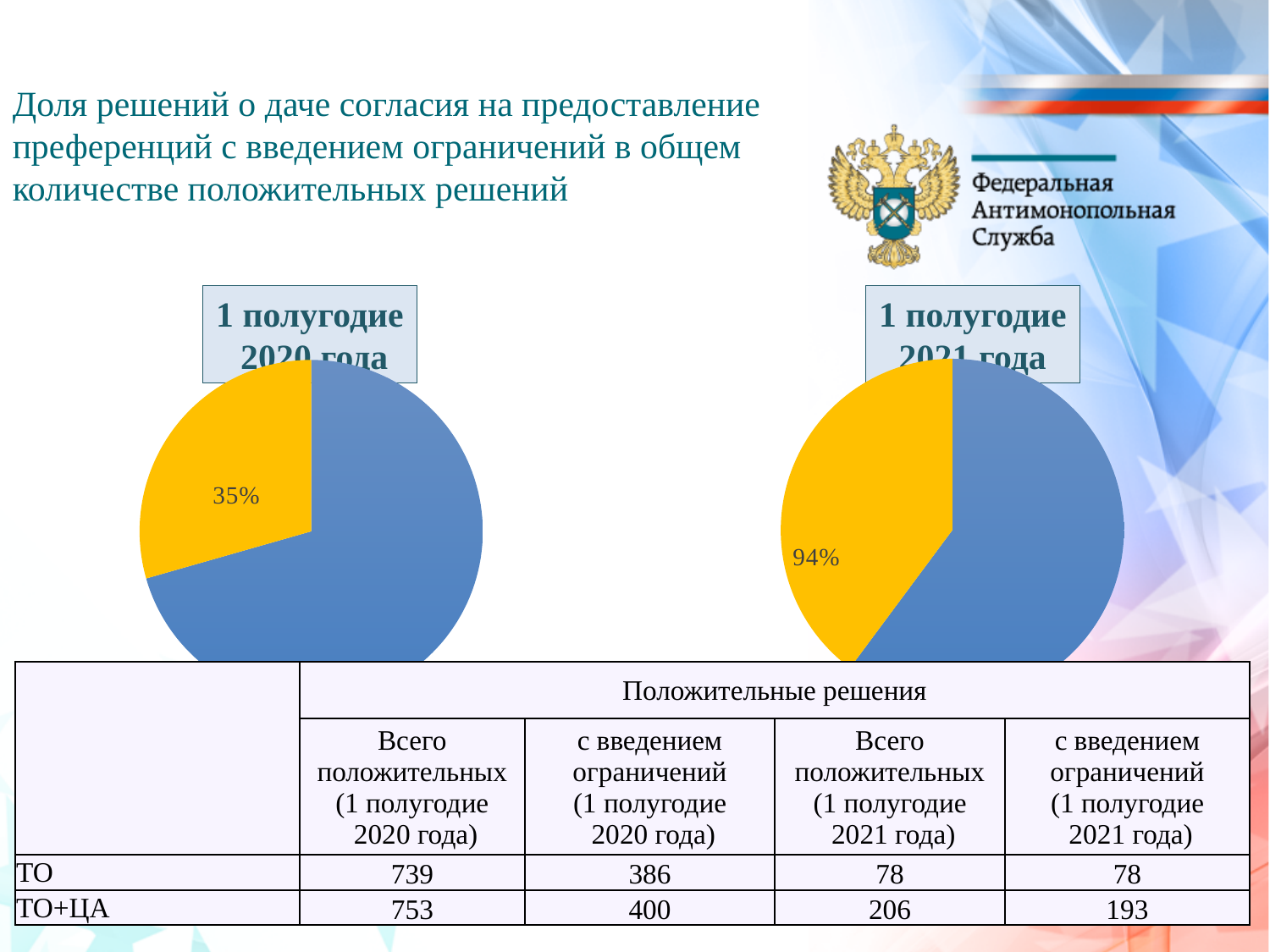
Which pie chart has the larger printed percentage on its yellow slice, "1 полугодие 2020 года" or "1 полугодие 2021 года"? 1 полугодие 2021 года In the pie chart titled "1 полугодие 2020 года", which slice is larger, the blue one or the yellow one? The blue one How many slices does the pie chart titled "1 полугодие 2020 года" have? 2 In the pie chart titled "1 полугодие 2020 года", what percentage is printed on the yellow slice? 35% In the pie chart titled "1 полугодие 2021 года", what percentage is printed on the yellow slice? 94% What kind of chart is the right chart titled "1 полугодие 2021 года"? Pie chart What is the title of the right pie chart on the slide? 1 полугодие 2021 года What is the title of the left pie chart on the slide? 1 полугодие 2020 года What kind of chart is the left chart titled "1 полугодие 2020 года"? Pie chart Is the percentage printed on the yellow slice of the pie chart titled "1 полугодие 2020 года" greater or less than 50%? less How many slices does the pie chart titled "1 полугодие 2021 года" have? 2 How many pie charts are shown on the slide? 2